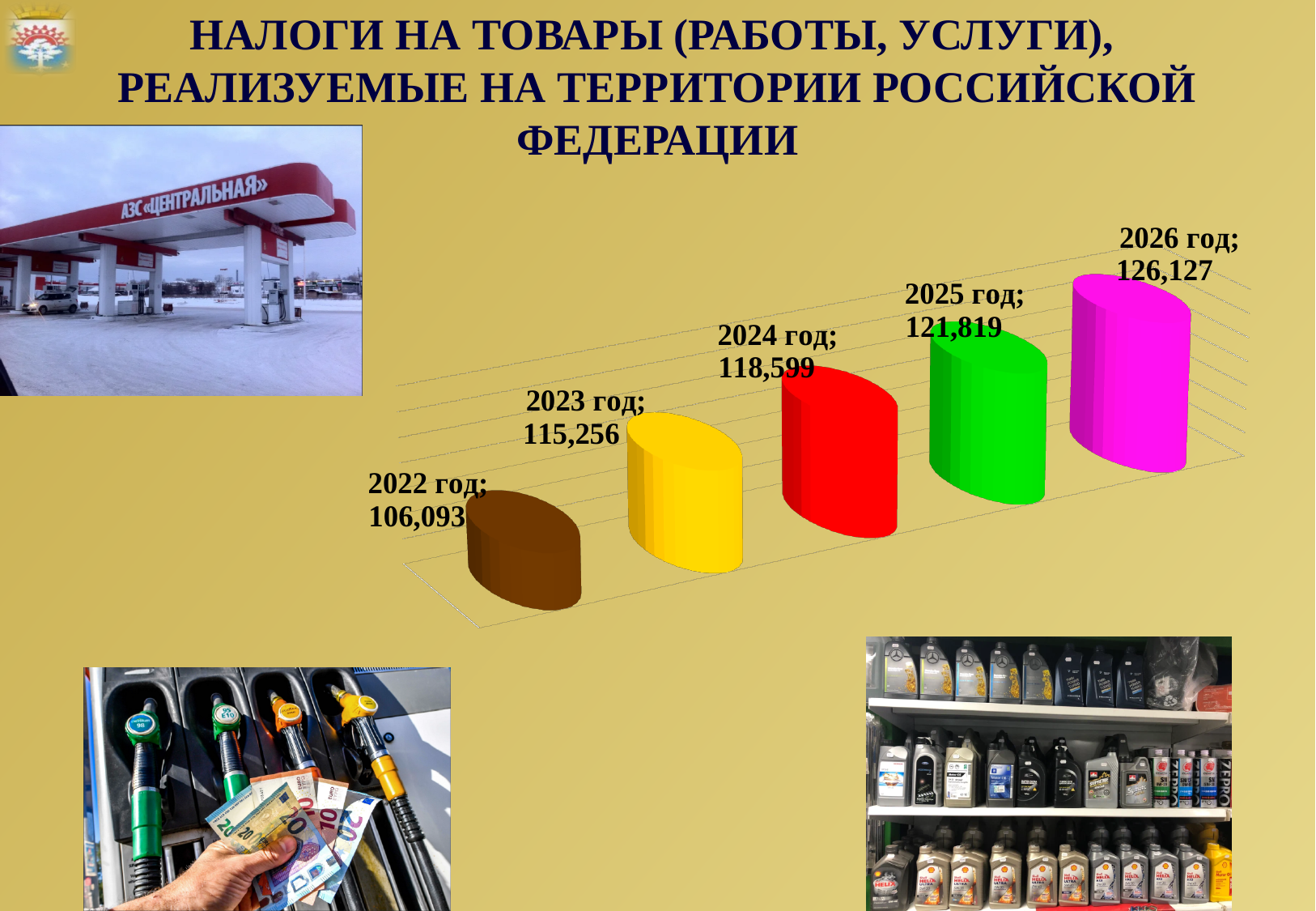
Which year has the highest value? 2026 год Which year has the lowest value? 2022 год Which is larger, the value for 2025 год or the value for 2023 год? 2025 год What kind of chart is shown on the slide? Bar chart How many years are shown in the chart? 5 What is the difference between the values for 2025 год and 2024 год? 3,220 What is the value for 2024 год? 118,599 Do the values rise or fall from 2022 год to 2026 год? Rise What is the value for 2026 год? 126,127 What is the value for 2022 год? 106,093 What is the difference between the values for 2026 год and 2022 год? 20,034 What is the difference between the values for 2023 год and 2022 год? 9,163